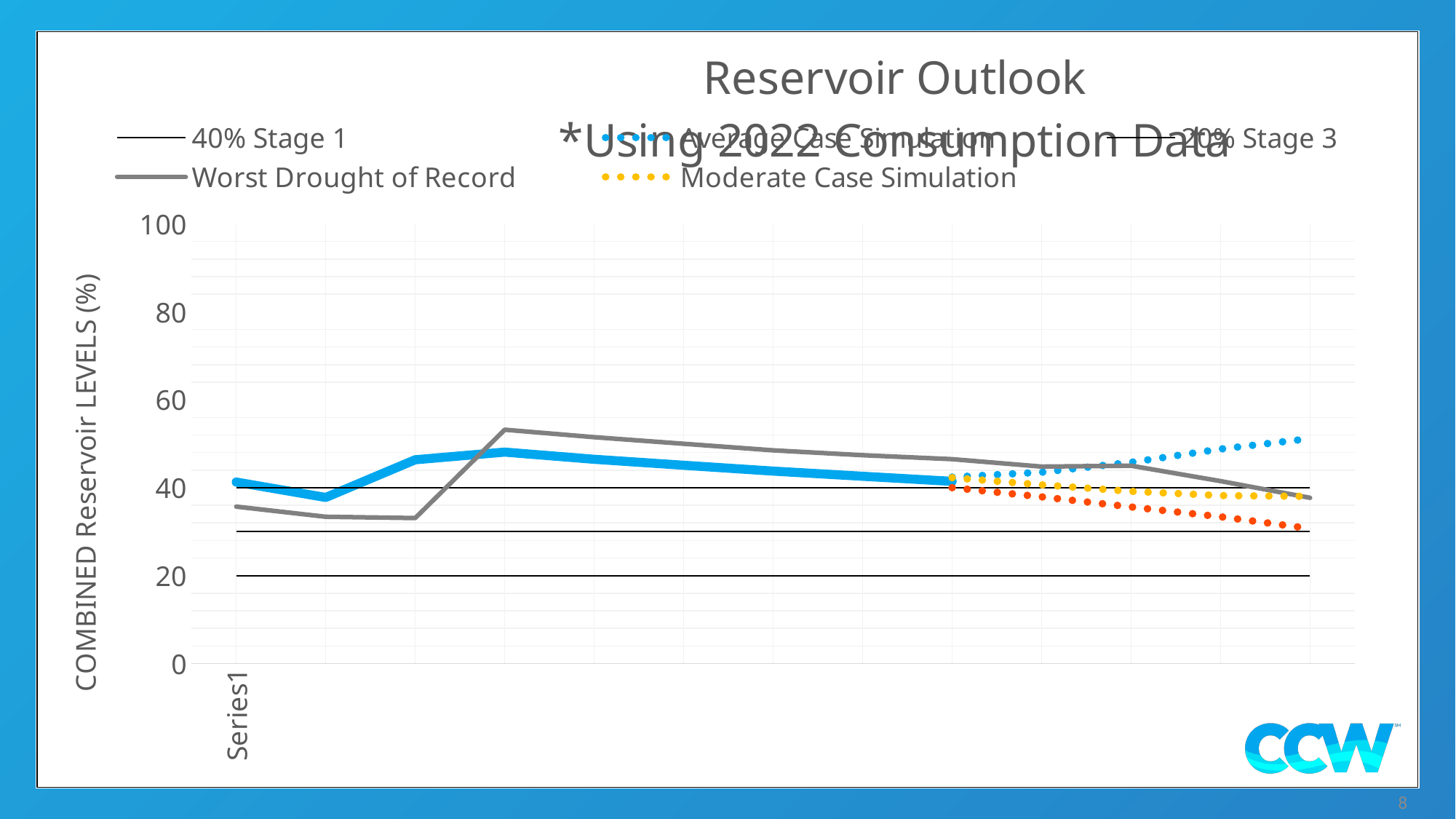
What is the label of the vertical axis? COMBINED Reservoir LEVELS (%) What kind of chart is shown on the slide? line chart At what level does the 40% Stage 1 line sit on the vertical axis? 40 Is the starting value of the Worst Drought of Record line greater or less than 40? less At what level does the 20% Stage 3 line sit on the vertical axis? 20 What is the highest tick value shown on the vertical axis? 100 Is the peak value of the Worst Drought of Record line greater or less than 40? greater Does the Worst Drought of Record line rise or fall over its final segment at the right of the chart? fall At the right end of the chart, which is higher: the Average Case Simulation line or the Worst Drought of Record line? Average Case Simulation Does the Average Case Simulation dotted line rise or fall toward the right end of the chart? rise What is the title of the chart? Reservoir Outlook *Using 2022 Consumption Data Is the final value of the Average Case Simulation line greater or less than 40? greater